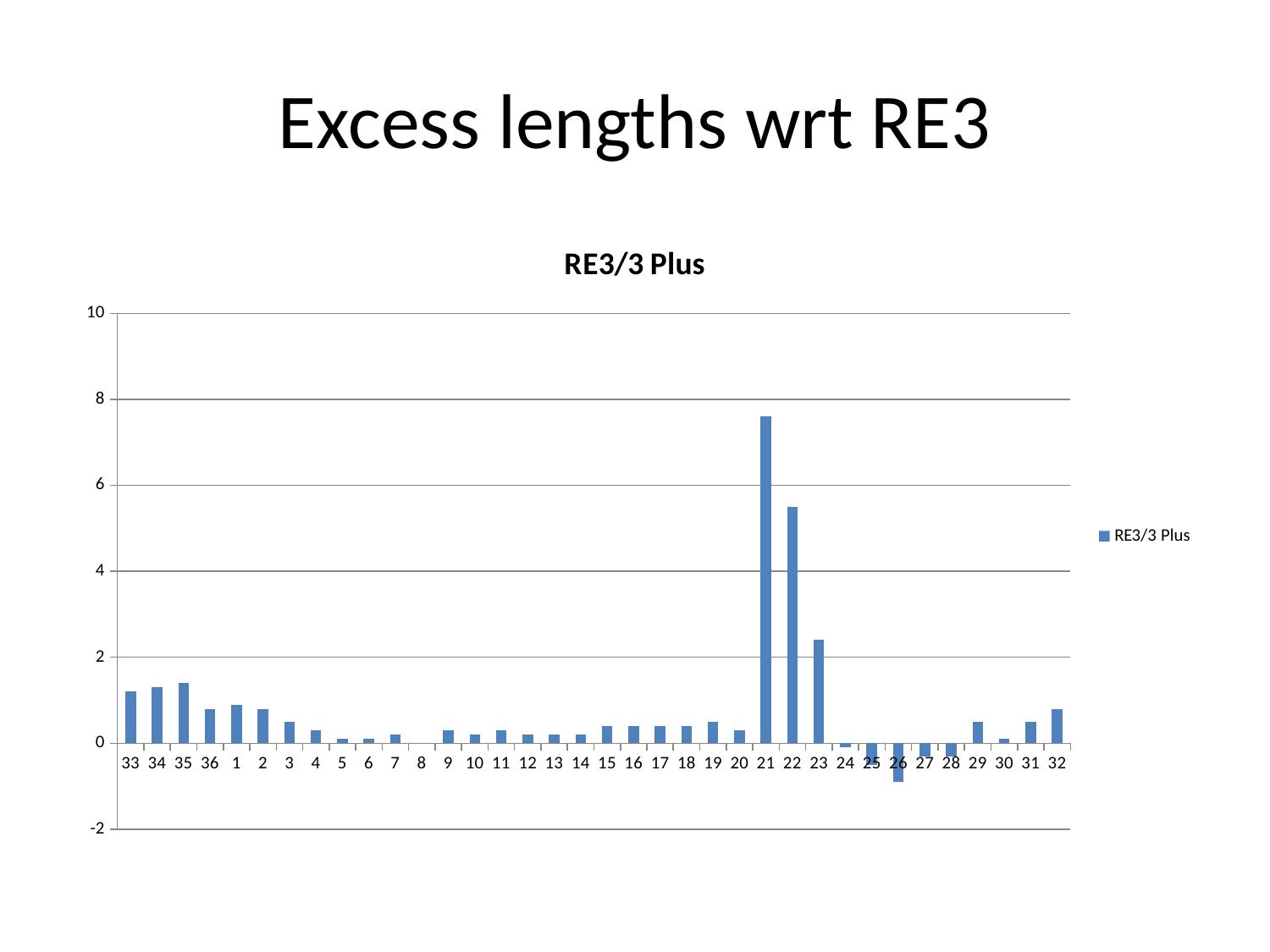
Is the value for category 26 greater or less than 0? less Is the value for category 21 greater or less than 6? greater Is the value for category 22 greater or less than 4? greater Which has the larger value, category 35 or category 36? 35 Which has the larger value, category 21 or category 22? 21 What is the title of the chart? RE3/3 Plus How many series does the legend list? 1 Which category has the highest value? 21 How many categories are shown on the x axis? 36 What kind of chart is shown on the slide? bar chart Which category has the lowest value? 26